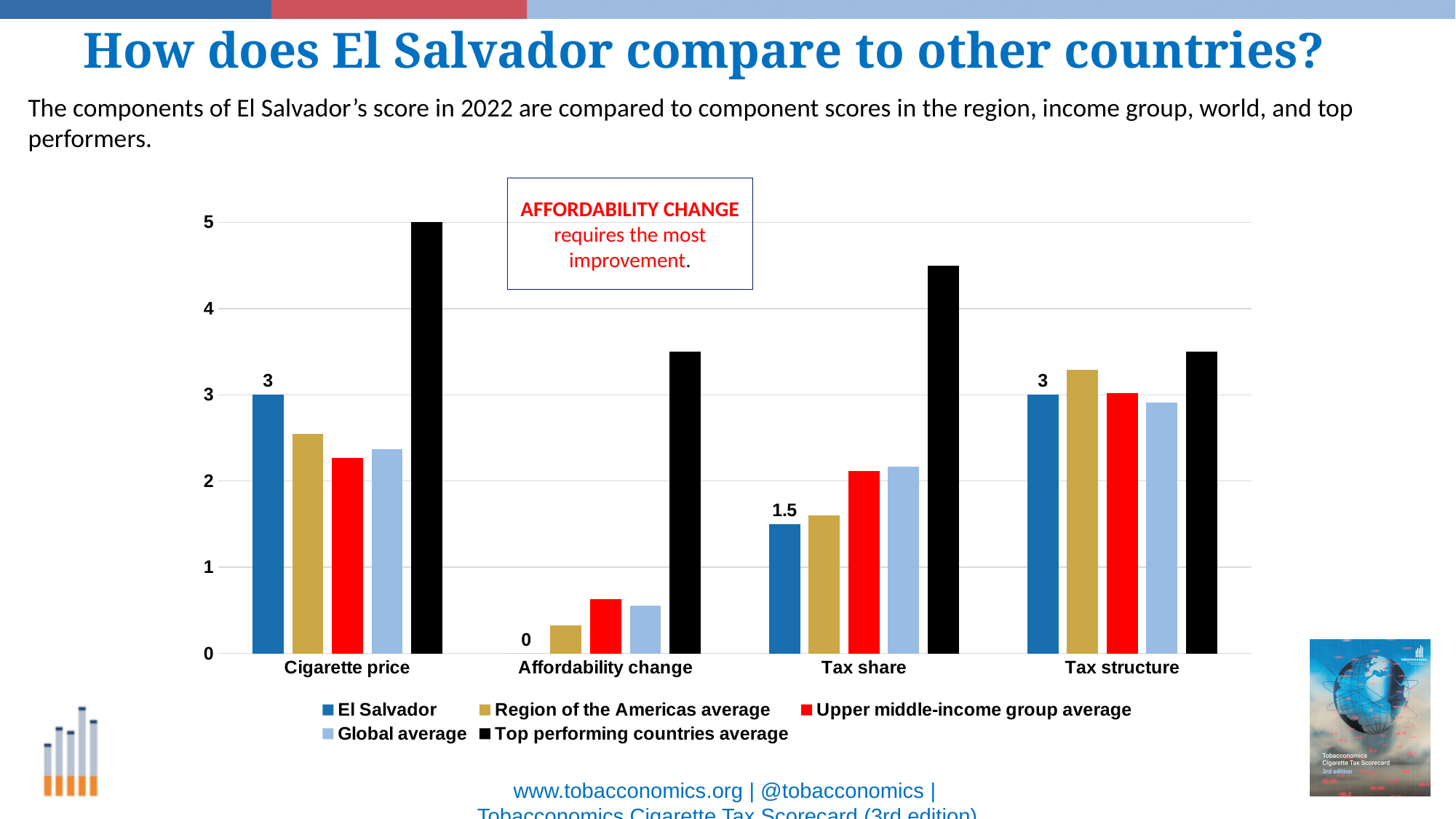
What kind of chart is shown on the slide? bar chart How many components are shown on the x axis? 4 How many series does the legend list? 5 What is the Top performing countries average for Cigarette price? 5 What is El Salvador's score for Tax share? 1.5 What is El Salvador's score for Affordability change? 0 What is El Salvador's score for Tax structure? 3 For El Salvador, which is larger: the Cigarette price score or the Tax share score? Cigarette price Is the Top performing countries average for Tax share greater or less than 4? greater What is the difference between El Salvador's Cigarette price score and its Tax share score? 1.5 What is El Salvador's score for Cigarette price? 3 Which component has the lowest score for El Salvador? Affordability change